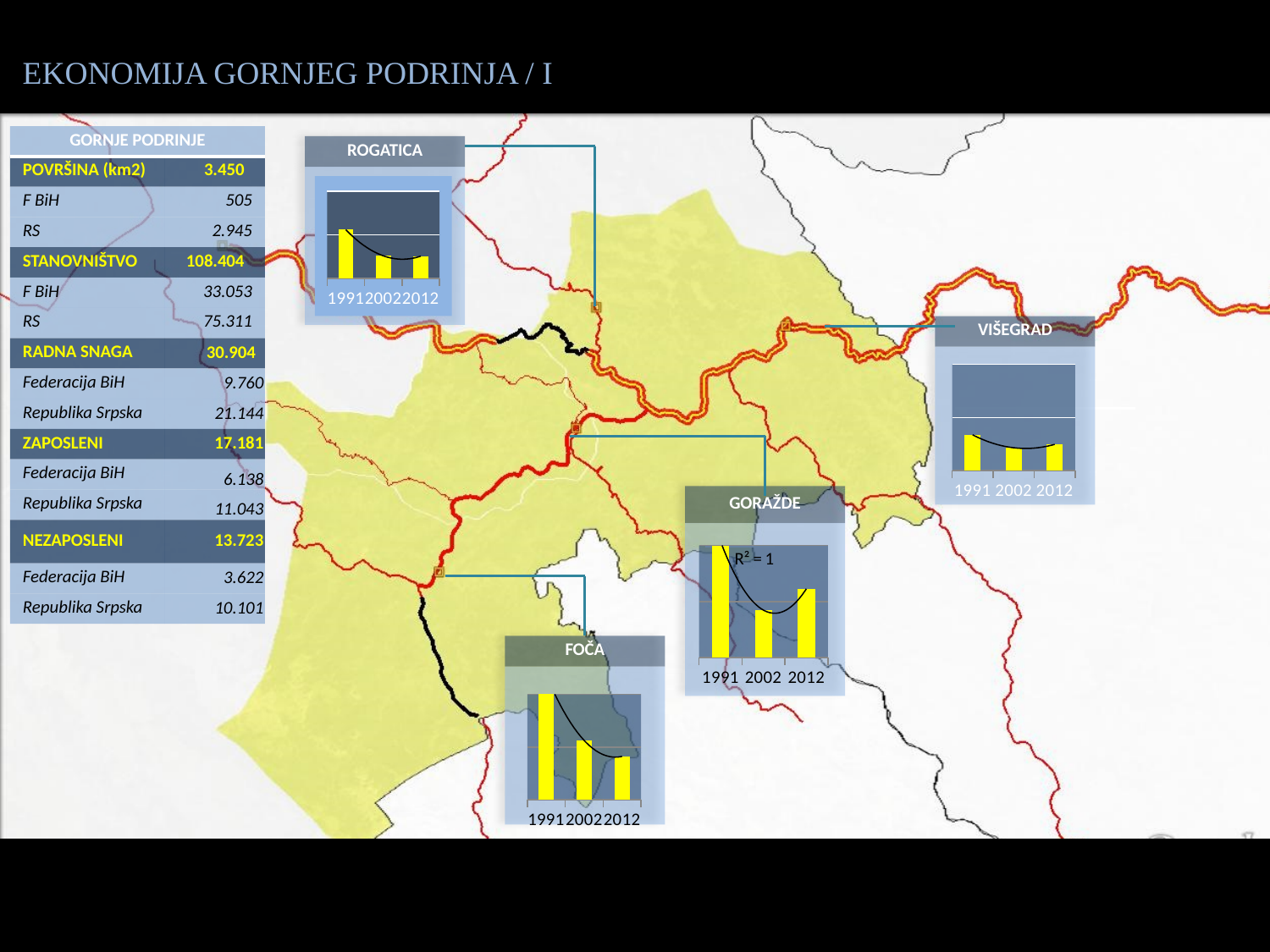
In the FOČA chart, which year has the highest bar? 1991 In the FOČA chart, is the bar for 1991 larger or smaller than the bar for 2002? larger In the FOČA chart, which year has the lowest bar? 2012 In the FOČA chart, do the values rise or fall from 1991 to 2012? fall In the GORAŽDE chart, which year has the lowest bar? 2002 What kind of chart is shown in the GORAŽDE panel? bar chart What R-squared value is printed on the GORAŽDE chart? R² = 1 How many bars (years) are plotted in the FOČA chart? 3 In the GORAŽDE chart, is the bar for 2012 larger or smaller than the bar for 2002? larger In the GORAŽDE chart, which year has the highest bar? 1991 In the ROGATICA chart, which year has the highest bar? 1991